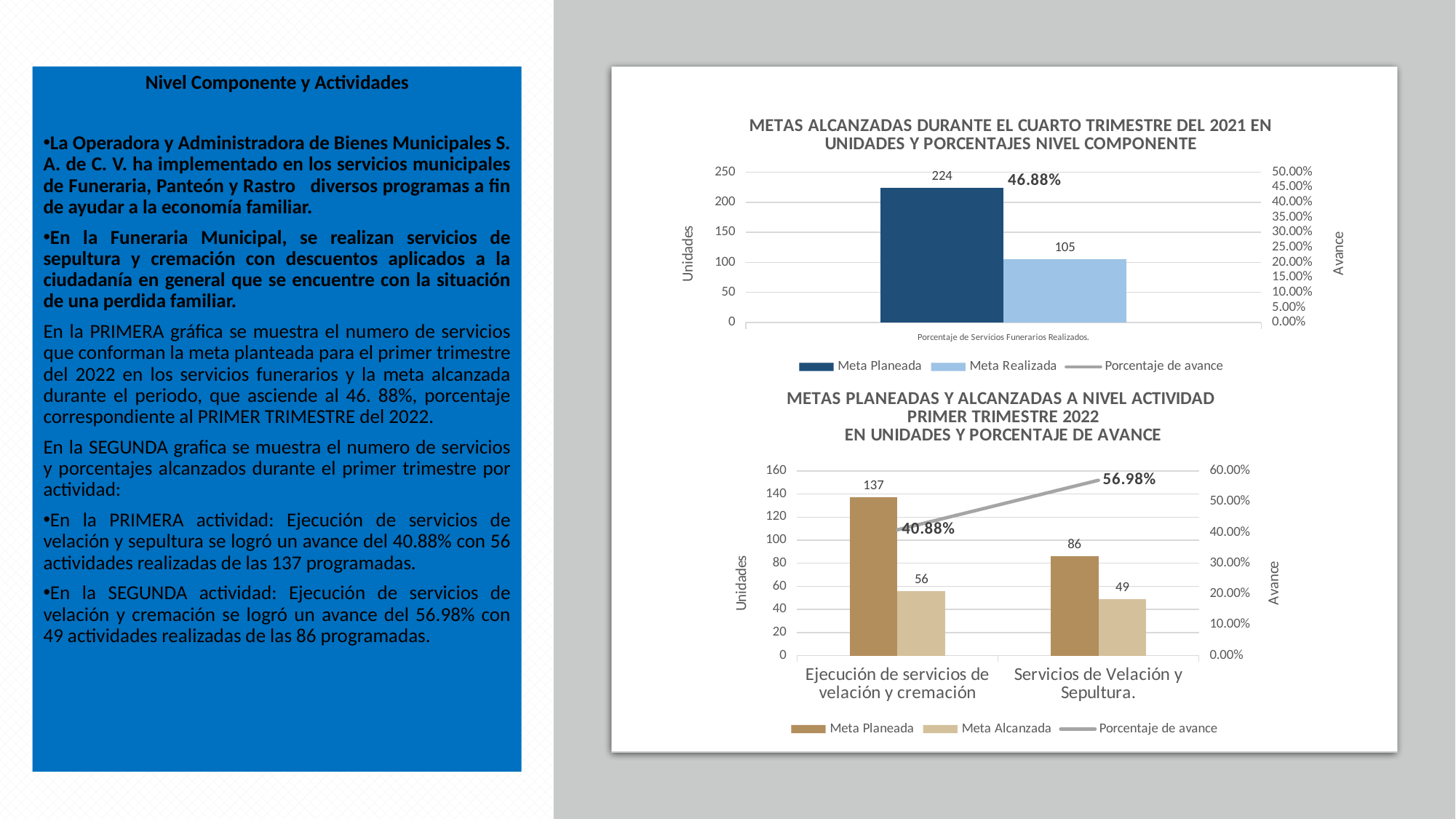
In the bottom chart, what is the Meta Alcanzada for Servicios de Velación y Sepultura? 49 In the bottom chart, what is the difference between Meta Planeada and Meta Alcanzada for Ejecución de servicios de velación y cremación? 81 In the bottom chart, how many categories are shown on the x axis? 2 In the top chart, what is the value of Meta Realizada? 105 In the bottom chart, what is the Meta Planeada for Ejecución de servicios de velación y cremación? 137 In the bottom chart, what is the Porcentaje de avance for Servicios de Velación y Sepultura? 56.98% In the top chart, what is the value of Meta Planeada? 224 In the bottom chart, does the Porcentaje de avance line rise or fall from the first category to the second? rise In the bottom chart, which category has the higher Meta Planeada? Ejecución de servicios de velación y cremación In the top chart, how many series does the legend list? 3 In the top chart, what is the difference between Meta Planeada and Meta Realizada? 119 In the top chart, what is the Porcentaje de avance shown? 46.88%